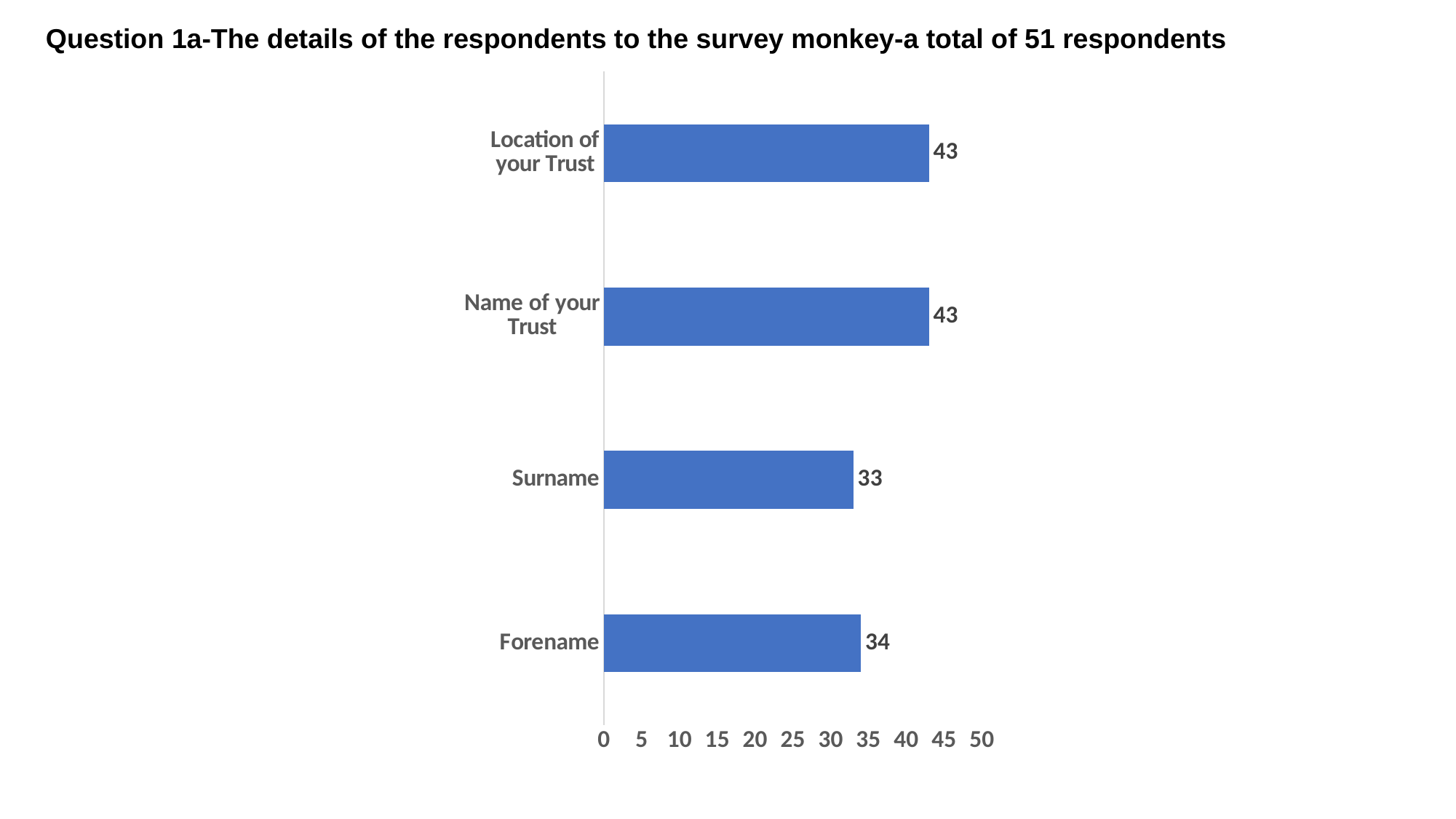
What is the value for Location of your Trust? 43 What is the difference between the values for Forename and Surname? 1 Which category has the lowest value? Surname What is the value for Forename? 34 Is the value for Surname greater or less than 40? less What kind of chart is shown on the slide? bar chart What is the difference between the values for Location of your Trust and Surname? 10 Which is larger, the value for Name of your Trust or the value for Forename? Name of your Trust What is the value for Name of your Trust? 43 What is the title of the chart? Question 1a-The details of the respondents to the survey monkey-a total of 51 respondents How many categories are shown in the chart? 4 What is the value for Surname? 33